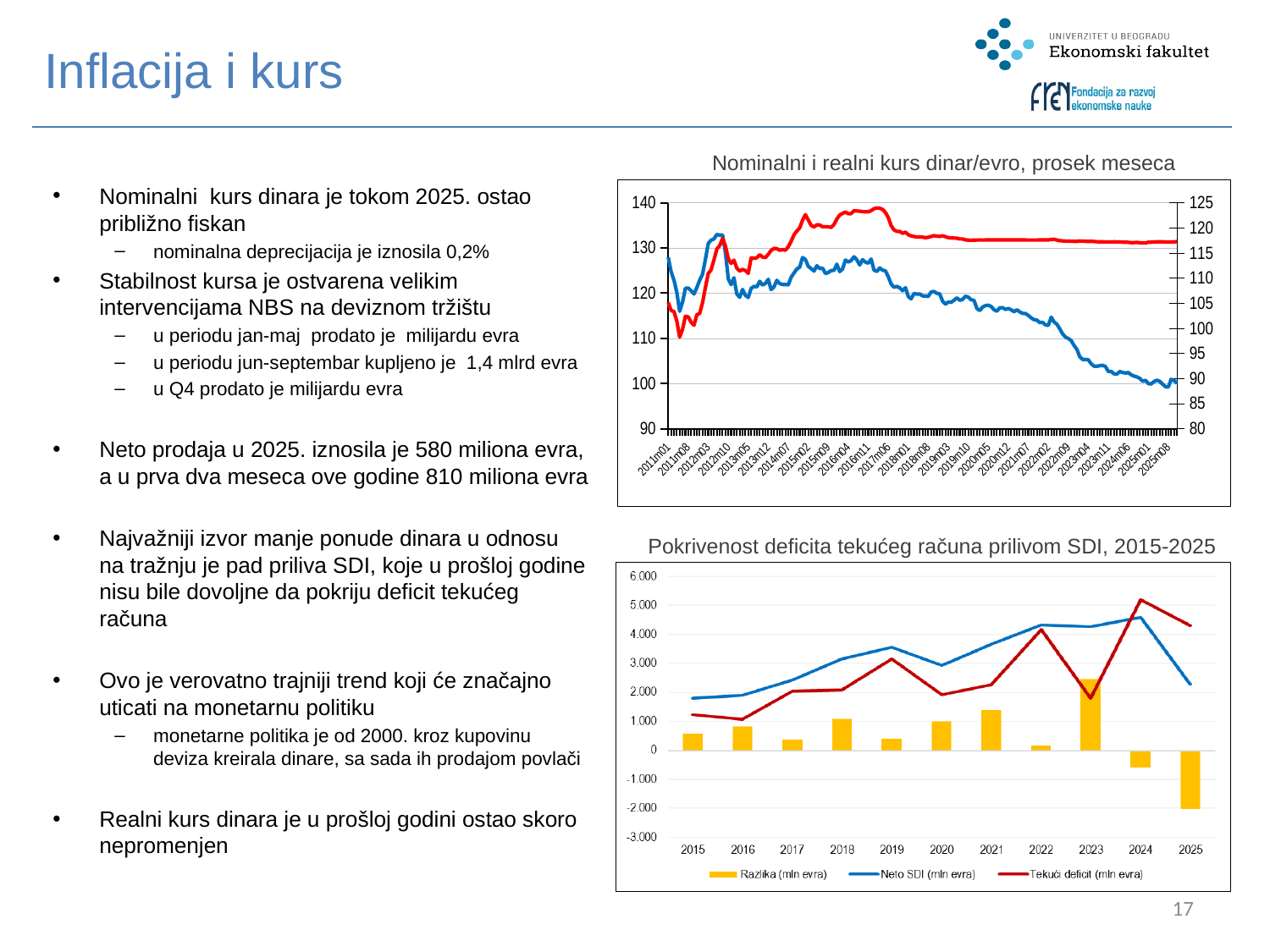
In the top chart 'Nominalni i realni kurs dinar/evro, prosek meseca', how many lines are plotted? 2 What type of chart is the top chart titled 'Nominalni i realni kurs dinar/evro, prosek meseca'? line chart In the bottom chart 'Pokrivenost deficita tekućeg računa prilivom SDI, 2015-2025', is the Neto SDI (mln evra) value for 2024 greater or less than 4.000? greater In the bottom chart 'Pokrivenost deficita tekućeg računa prilivom SDI, 2015-2025', which year has the lowest Razlika (mln evra) bar? 2025 How many years are shown on the x axis of the bottom chart 'Pokrivenost deficita tekućeg računa prilivom SDI, 2015-2025'? 11 In the bottom chart 'Pokrivenost deficita tekućeg računa prilivom SDI, 2015-2025', which is larger in 2025: Neto SDI (mln evra) or Tekući deficit (mln evra)? Tekući deficit (mln evra) In the bottom chart 'Pokrivenost deficita tekućeg računa prilivom SDI, 2015-2025', which series is drawn as bars? Razlika (mln evra) In the bottom chart 'Pokrivenost deficita tekućeg računa prilivom SDI, 2015-2025', which year has the highest Tekući deficit (mln evra) value? 2024 In the bottom chart 'Pokrivenost deficita tekućeg računa prilivom SDI, 2015-2025', which year has the highest Razlika (mln evra) bar? 2023 In the bottom chart 'Pokrivenost deficita tekućeg računa prilivom SDI, 2015-2025', is the Razlika (mln evra) value for 2025 greater or less than -1.000? less In the top chart 'Nominalni i realni kurs dinar/evro, prosek meseca', does the blue line rise or fall from 2017 to 2025? fall How many series does the legend of the bottom chart 'Pokrivenost deficita tekućeg računa prilivom SDI, 2015-2025' list? 3